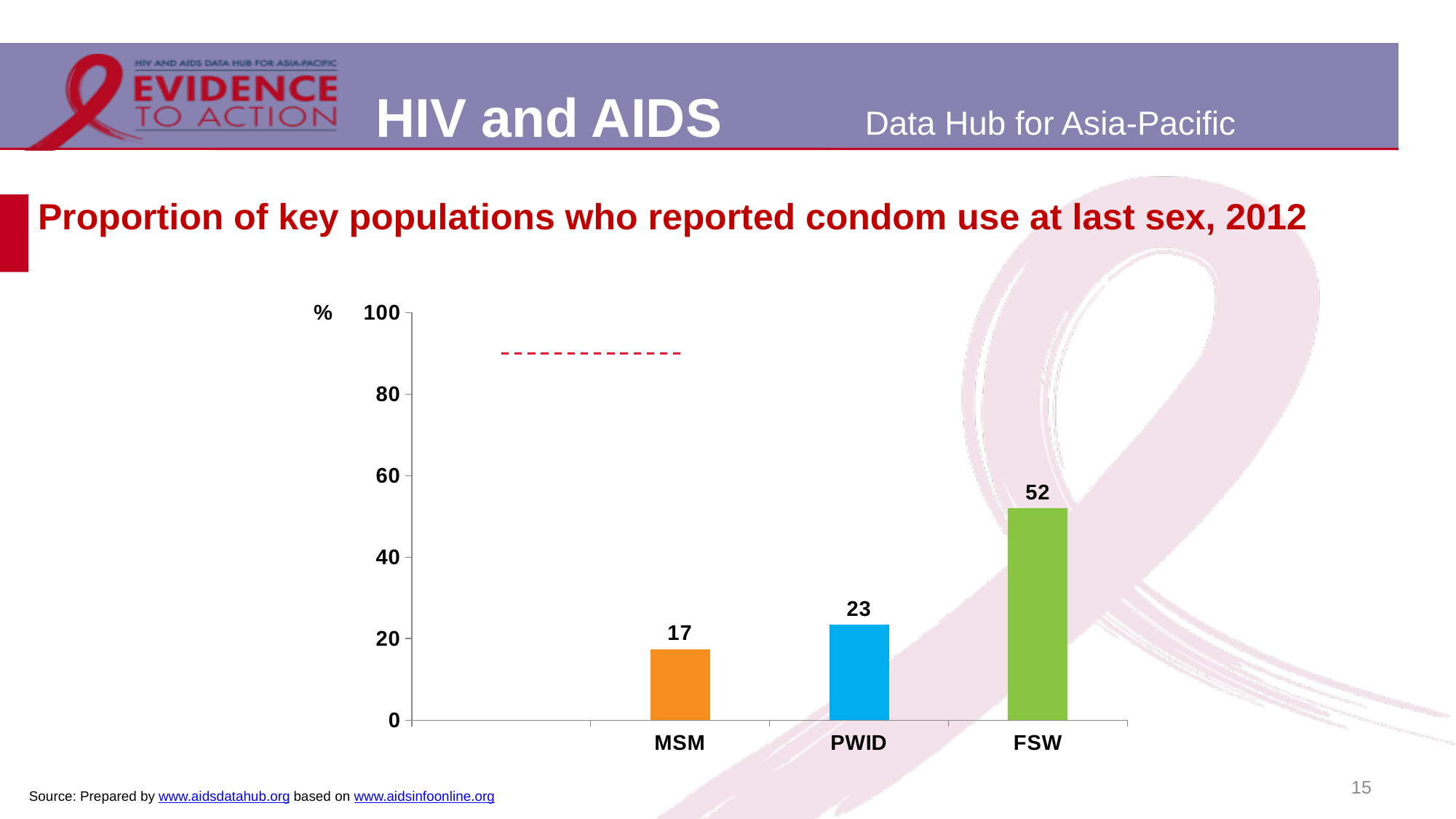
Is the value for FSW greater or less than 40? greater What is the difference between the values for FSW and MSM? 35 How many categories are shown on the x axis? 3 Which category has the lowest value? MSM Which category has the highest value? FSW What is the difference between the values for PWID and MSM? 6 What is the title of the chart? Proportion of key populations who reported condom use at last sex, 2012 What is the value for FSW? 52 What kind of chart is shown on the slide? bar chart Which is larger, the value for PWID or the value for FSW? FSW What is the value for PWID? 23 What is the value for MSM? 17